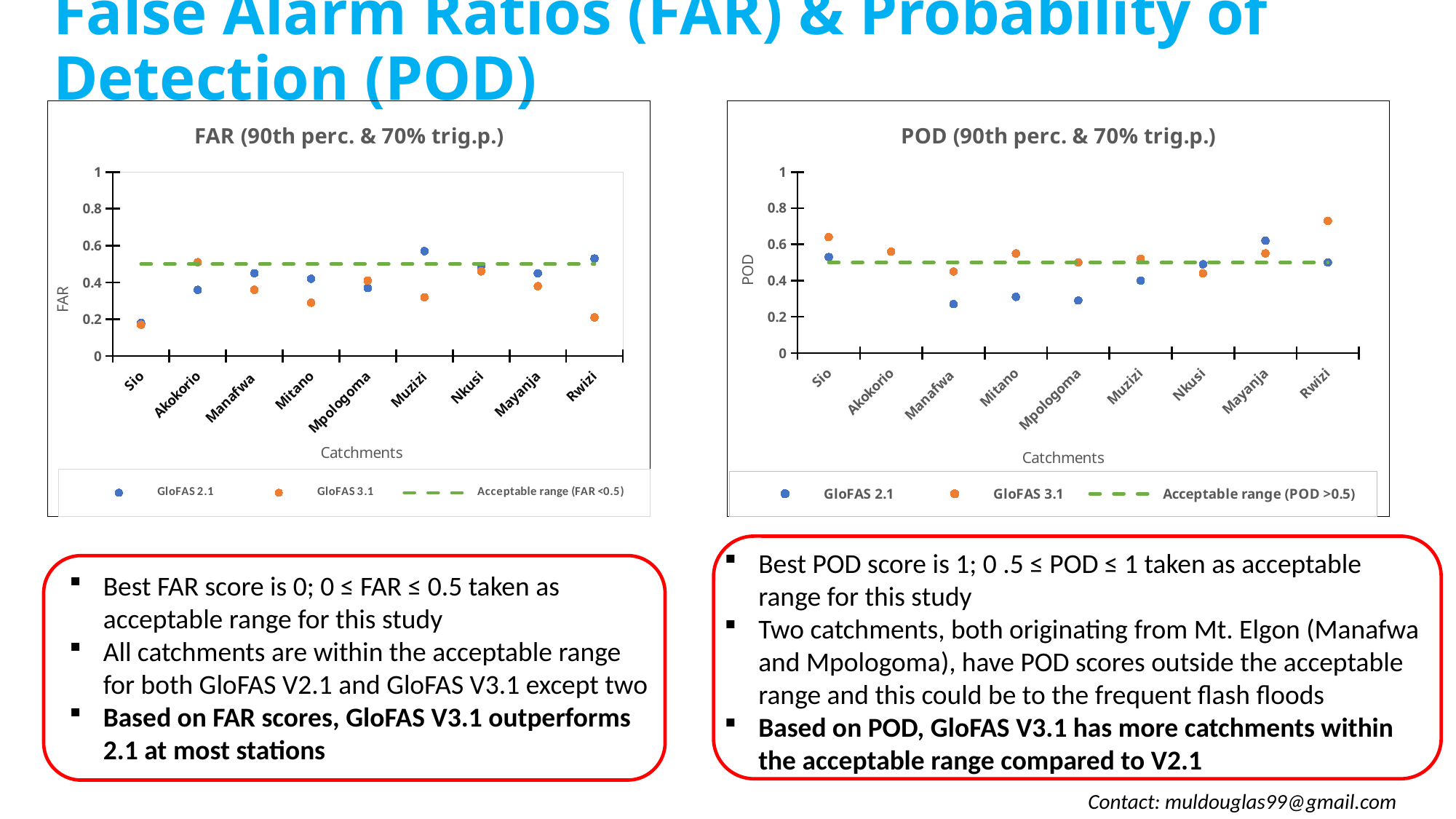
In the POD (90th perc. & 70% trig.p.) chart, is the GloFAS 2.1 value for Manafwa greater or less than 0.4? less What kind of chart is the FAR (90th perc. & 70% trig.p.) chart? scatter chart In the POD (90th perc. & 70% trig.p.) chart, which catchment has the highest POD for GloFAS 2.1? Mayanja How many entries does the legend of the FAR (90th perc. & 70% trig.p.) chart list? 3 In the FAR (90th perc. & 70% trig.p.) chart, which catchment has the highest FAR for GloFAS 2.1? Muzizi What does the green dashed line in the POD (90th perc. & 70% trig.p.) chart represent, according to the legend? Acceptable range (POD >0.5) In the POD (90th perc. & 70% trig.p.) chart, which catchment has the highest POD for GloFAS 3.1? Rwizi In the FAR (90th perc. & 70% trig.p.) chart, which catchment has the lowest FAR for GloFAS 2.1? Sio In the FAR (90th perc. & 70% trig.p.) chart, which is larger for Rwizi, the GloFAS 2.1 value or the GloFAS 3.1 value? GloFAS 2.1 In the FAR (90th perc. & 70% trig.p.) chart, is the GloFAS 2.1 value for Muzizi greater or less than 0.4? greater In the POD (90th perc. & 70% trig.p.) chart, which is larger for Rwizi, the GloFAS 2.1 value or the GloFAS 3.1 value? GloFAS 3.1 How many catchments are shown on the x axis of the POD (90th perc. & 70% trig.p.) chart? 9